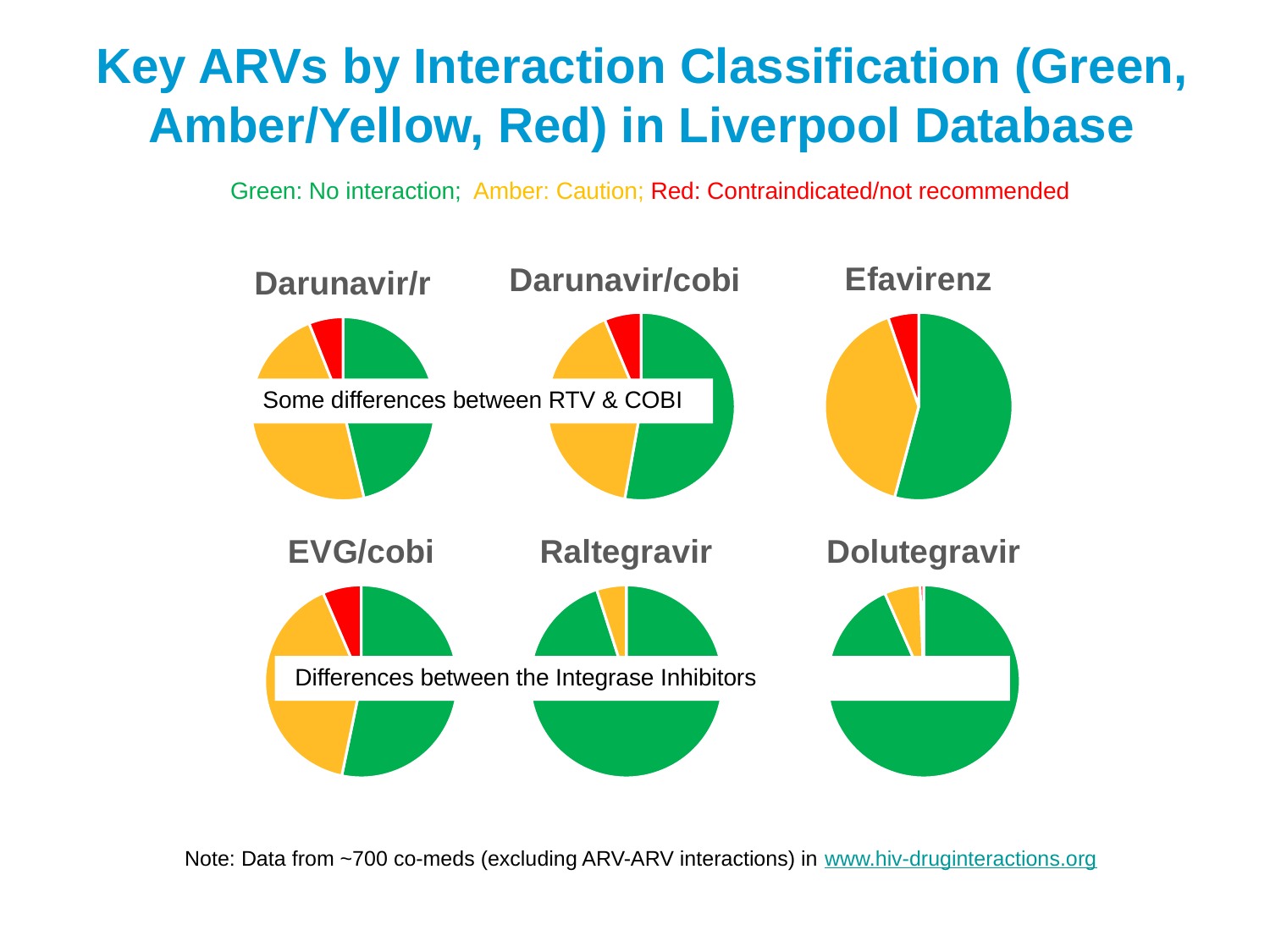
In the EVG/cobi chart, which slice is larger, green or red? Green How many slices does the Raltegravir pie chart have? 2 In the Raltegravir chart, which interaction classification has the largest slice? Green (No interaction) What kind of chart is the Darunavir/r chart? Pie chart How many slices does the Darunavir/cobi pie chart have? 3 How many pie charts are shown on the slide? 6 In the Dolutegravir chart, which interaction classification has the largest slice? Green (No interaction) Which three charts are in the bottom row of the slide? EVG/cobi, Raltegravir, Dolutegravir In the Efavirenz chart, which slice is larger, green or amber? Green In the Darunavir/r chart, which interaction classification has the smallest slice? Red (Contraindicated/not recommended) Which colour represents 'No interaction' in the charts? Green In the Efavirenz chart, which interaction classification has the smallest slice? Red (Contraindicated/not recommended)